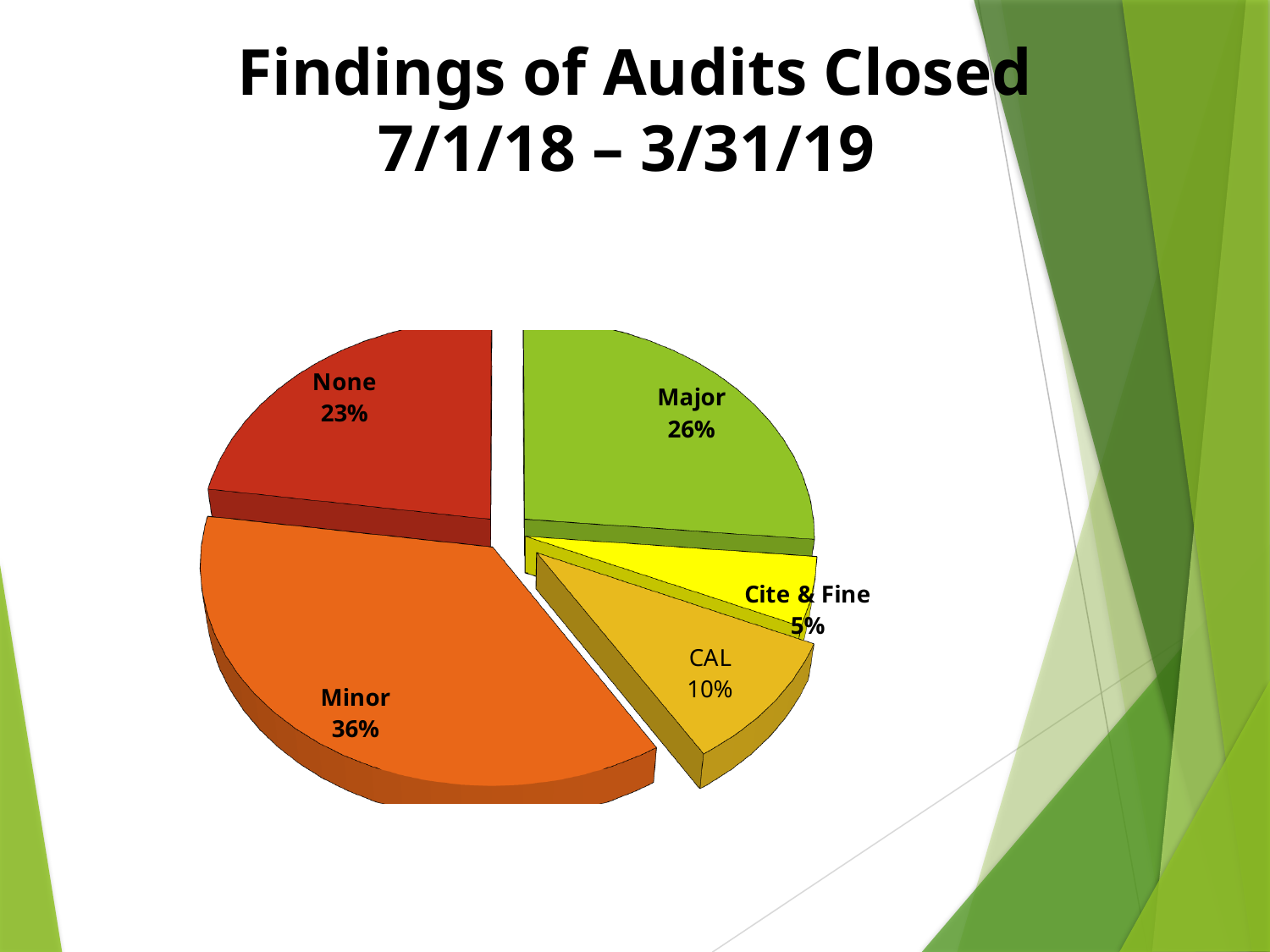
What percentage of audits closed resulted in Cite & Fine? 5% What percentage of audits closed resulted in CAL? 10% Which category has the largest share of the pie? Minor What is the difference in percentage points between Minor and Major findings? 10 Which is larger, the share for Major or the share for None? Major What percentage of audits closed had Minor findings? 36% What is the title of the slide containing the chart? Findings of Audits Closed 7/1/18 – 3/31/19 What percentage of audits closed had Major findings? 26% How many categories are shown in the pie chart? 5 What percentage of audits closed had no findings (None)? 23% What kind of chart is shown on the slide? pie chart Which category has the smallest share of the pie? Cite & Fine